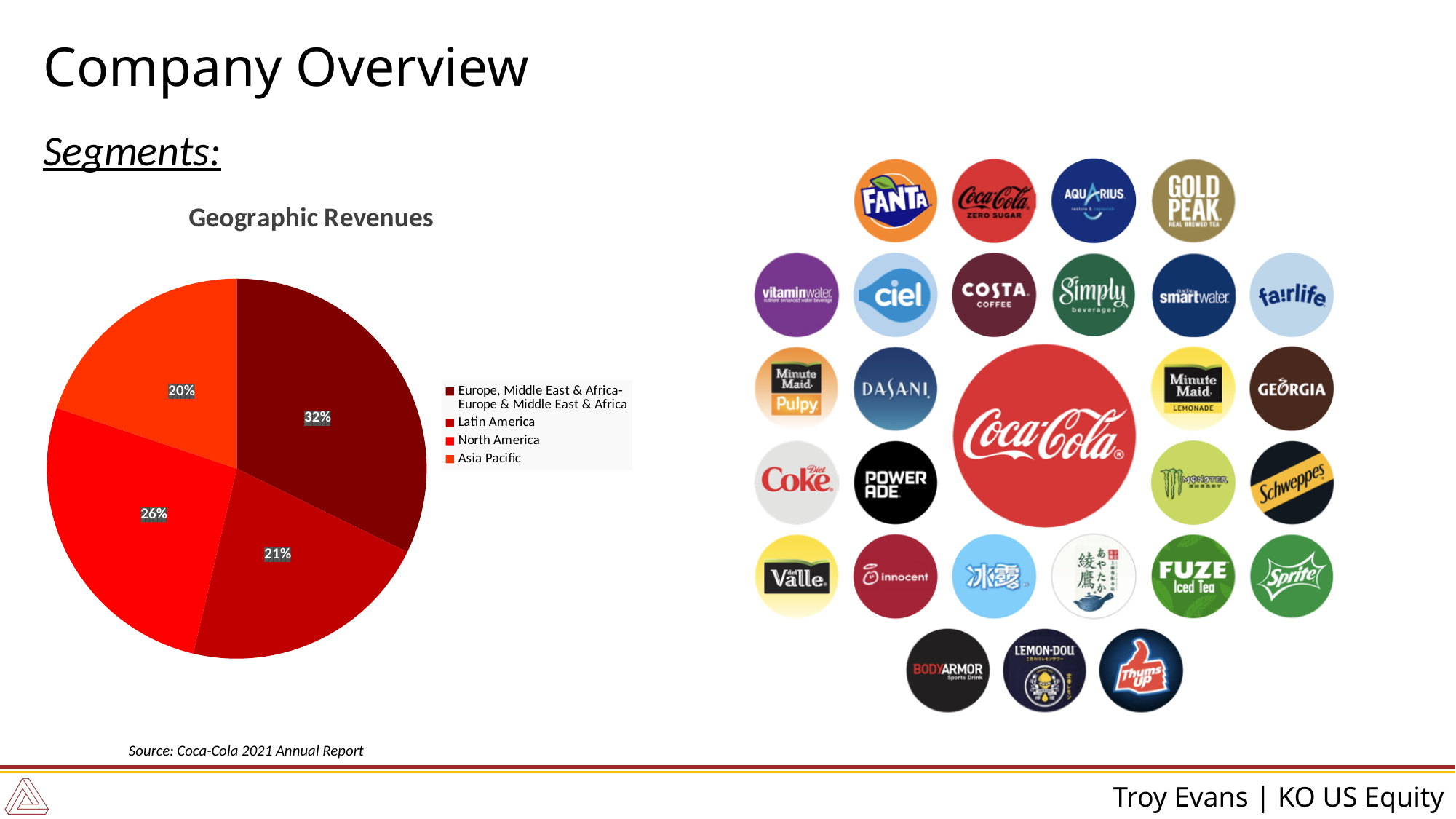
How many slices does the Geographic Revenues pie chart have? 4 In the Geographic Revenues pie chart, what share of revenue comes from Latin America? 21% In the Geographic Revenues pie chart, what share of revenue comes from North America? 26% In the Geographic Revenues pie chart, which is larger: the North America share or the Latin America share? North America In the Geographic Revenues pie chart, how many percentage points larger is the Europe, Middle East & Africa share than the North America share? 6 Which segment has the largest share in the Geographic Revenues pie chart? Europe, Middle East & Africa In the Geographic Revenues pie chart, what share of revenue comes from Europe, Middle East & Africa? 32% In the Geographic Revenues pie chart, what share of revenue comes from Asia Pacific? 20% Which segment has the smallest share in the Geographic Revenues pie chart? Asia Pacific What is the title of the pie chart on the slide? Geographic Revenues What source is cited for the Geographic Revenues chart? Coca-Cola 2021 Annual Report What is the chart type of the Geographic Revenues chart? pie chart